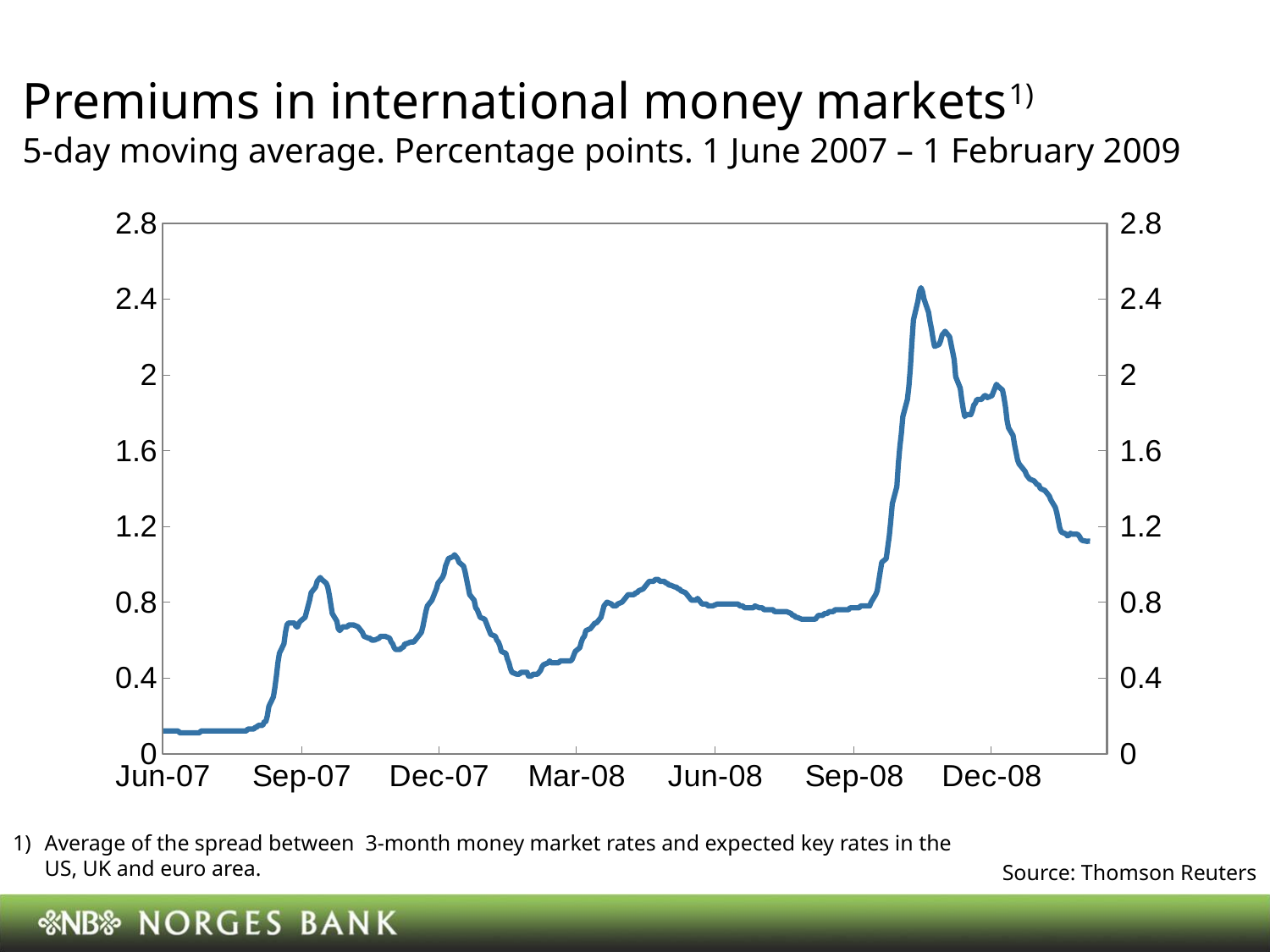
What is the source cited for the chart? Thomson Reuters Does the line reach its highest point before or after Sep-08? after Does the line rise or fall between Jun-07 and Sep-07? rise Is the highest point of the line greater or less than 2? greater Is the value at Mar-08 greater or less than 0.8? less Is the value at the end of the series (early 2009) greater or less than 0.8? greater What kind of chart is shown on the slide? line chart What is the title of the chart? Premiums in international money markets Does the line rise or fall from its peak in late 2008 to the end of the series? fall Which is higher: the local peak around Sep-07 or the local peak around Dec-07? Dec-07